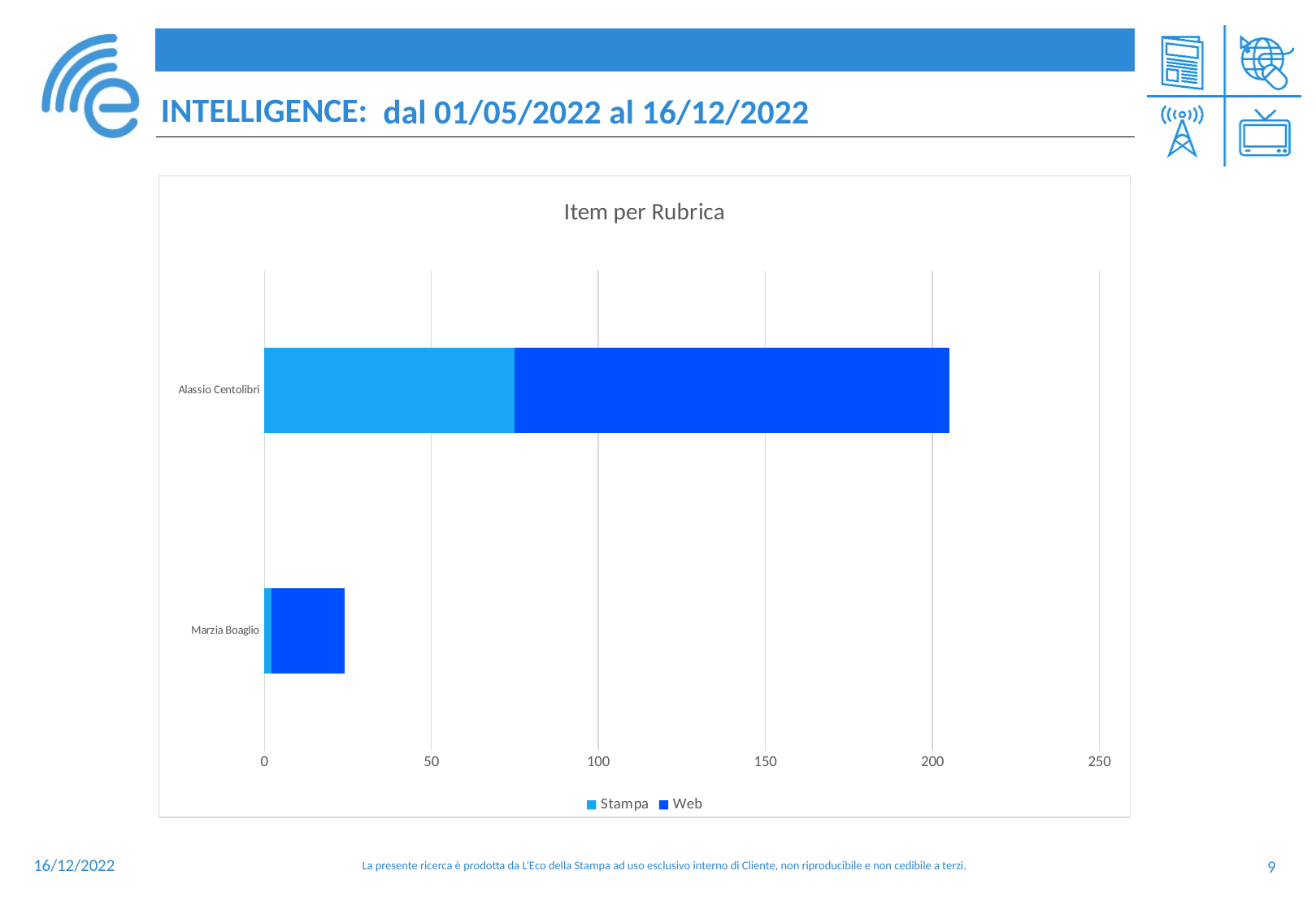
How many categories are shown on the chart? 2 Is the Stampa value for Alassio Centolibri greater or less than 50? greater Which series are listed in the legend? Stampa, Web What is the title of the chart? Item per Rubrica Is the total value for Marzia Boaglio greater or less than 50? less Which category has the highest total number of items? Alassio Centolibri Which category has the lowest total number of items? Marzia Boaglio Is the Stampa value for Alassio Centolibri greater or less than 100? less What type of chart is shown on the slide? bar chart For Alassio Centolibri, which series has the larger value, Stampa or Web? Web How many series does the legend list? 2